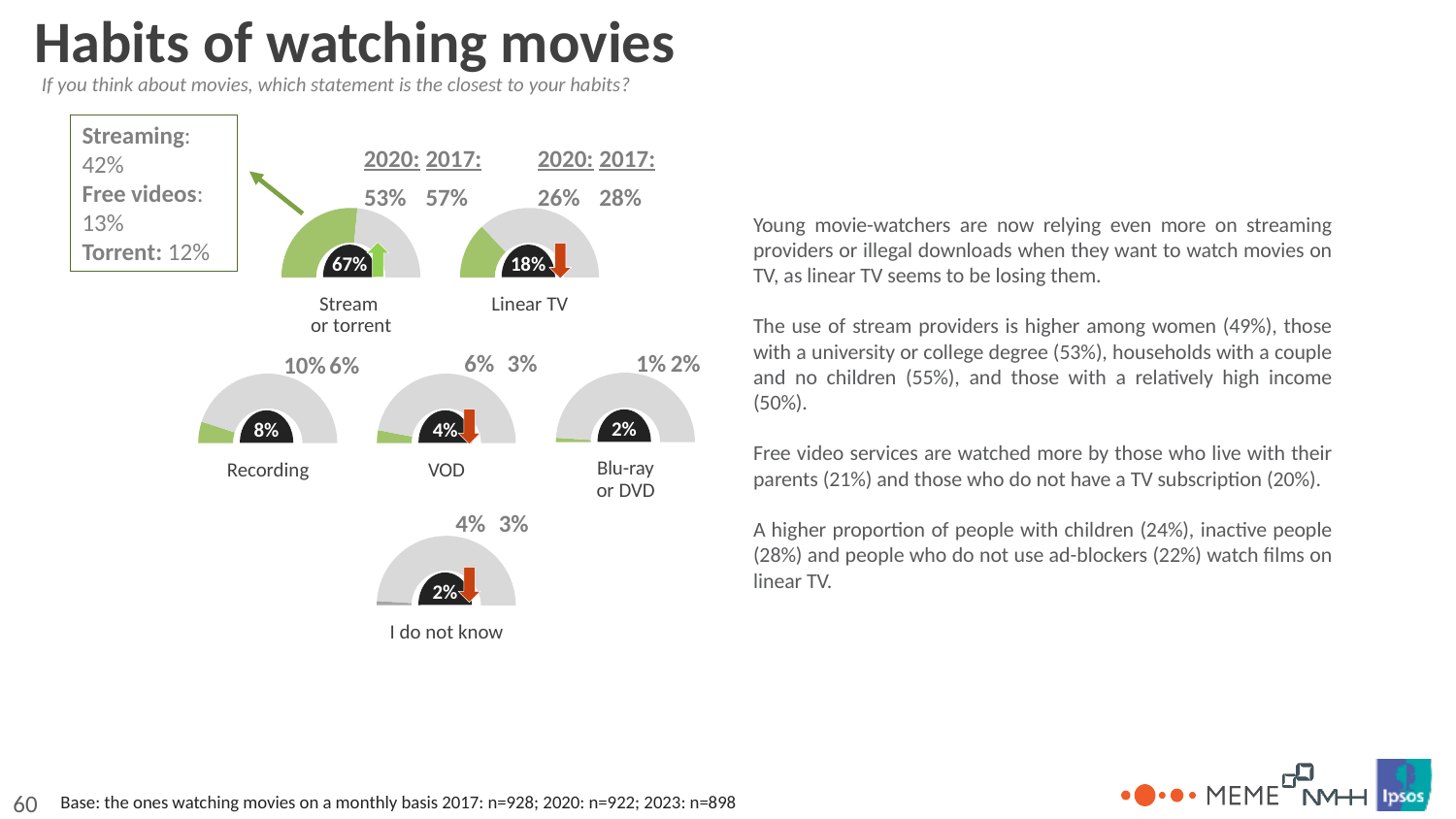
What is the current value shown on the gauge for Recording? 8% In the breakdown box for Stream or torrent, what is the value for Streaming? 42% What is the current value shown on the gauge for Linear TV? 18% What is the current value shown on the gauge for Blu-ray or DVD? 2% What was the 2020 value for Stream or torrent? 53% How many gauge charts are shown on the slide? 6 Which has the larger current value, Recording or VOD? Recording What was the 2017 value for Linear TV? 28% What is the current value shown on the gauge for VOD? 4% What is the current value shown on the gauge for Stream or torrent? 67% Which category has the highest current value among the gauges? Stream or torrent What is the difference between the current values for Stream or torrent and Linear TV? 49 percentage points